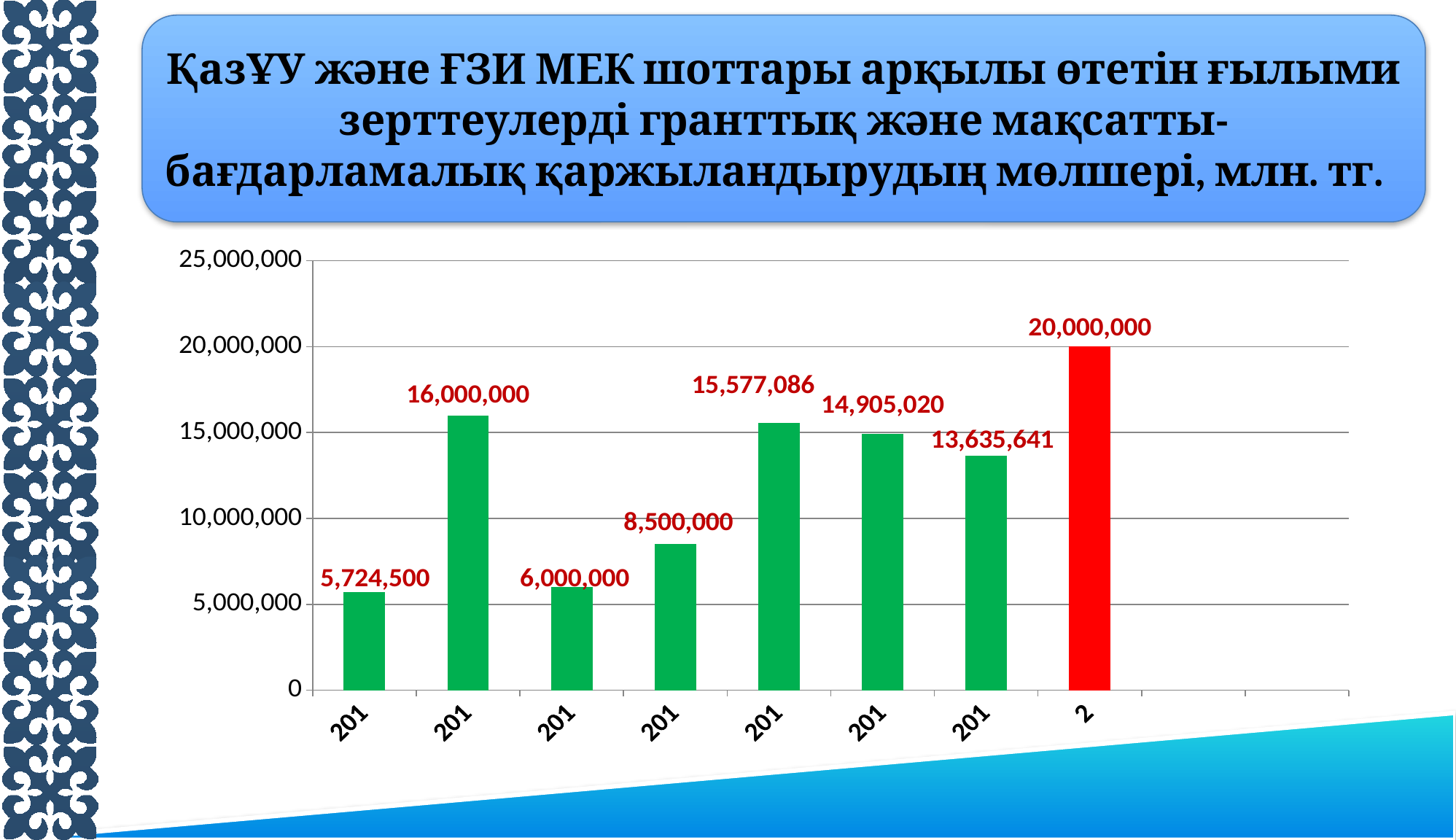
Which is larger: the value of the fourth bar from the left or the value of the third bar from the left? the fourth bar (8,500,000) What is the difference between the value of the red bar (20,000,000) and the second bar (16,000,000)? 4,000,000 What type of chart is shown on the slide? bar chart What colour is the bar with the highest value? red What is the value of the seventh bar from the left? 13,635,641 What is the value of the first bar on the left? 5,724,500 What is the value shown on the red bar (the last bar on the right)? 20,000,000 Which bar has the lowest value? the first bar on the left, 5,724,500 Which bar has the highest value? the red bar (last bar on the right), 20,000,000 How many bars are plotted in the chart? 8 What is the value of the fifth bar from the left? 15,577,086 What is the value of the second bar from the left? 16,000,000